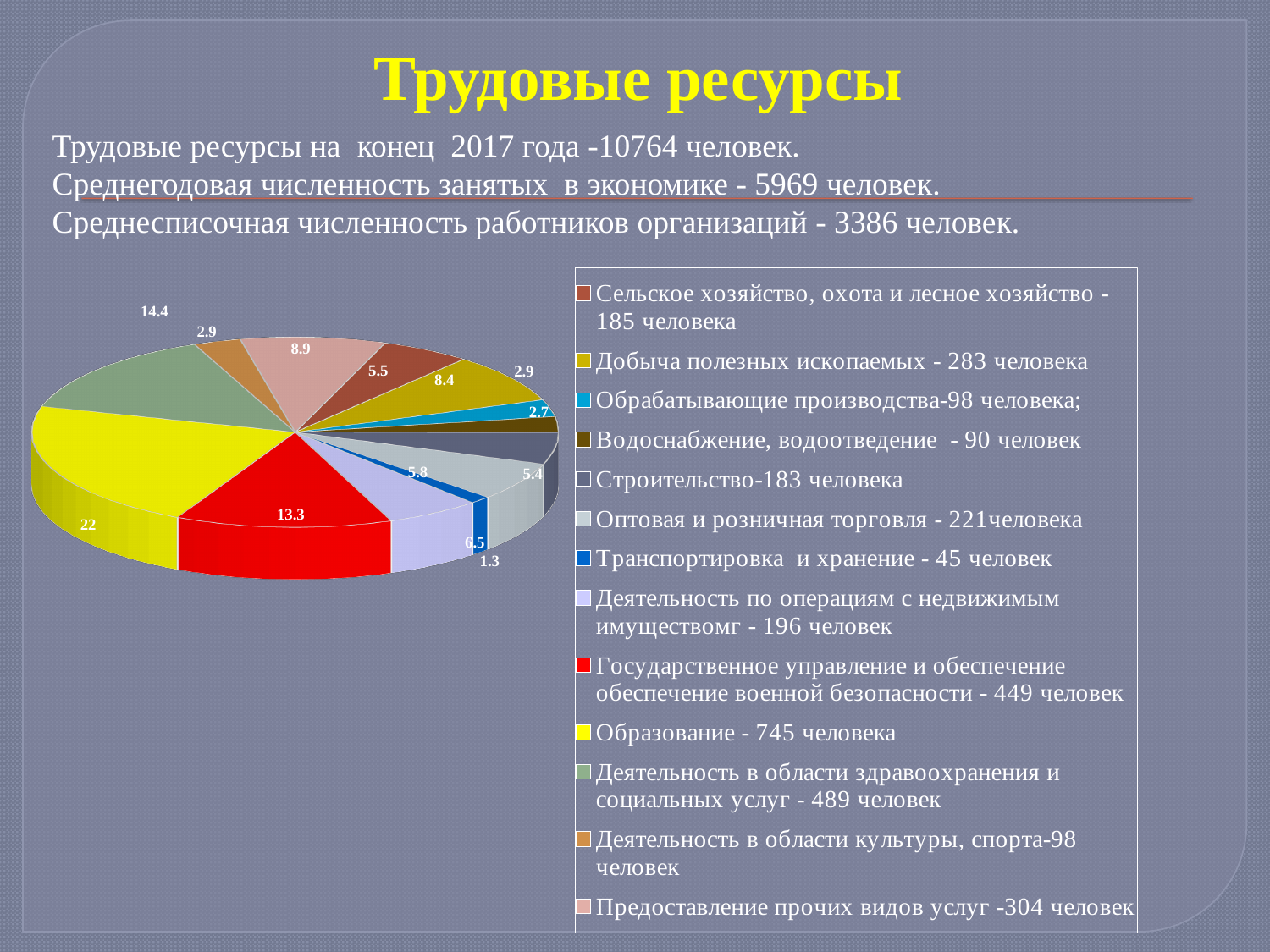
According to the legend, how many people are employed in Образование? 745 человека Which category has the largest slice of the pie chart? Образование What colour is the slice for Образование? yellow What is the data label on the slice for Предоставление прочих видов услуг? 8.9 How many categories does the legend of the pie chart list? 13 What is the data label on the slice for Государственное управление и обеспечение военной безопасности? 13.3 Which category has the smallest slice of the pie chart? Транспортировка и хранение Which slice is larger: Добыча полезных ископаемых or Сельское хозяйство, охота и лесное хозяйство? Добыча полезных ископаемых What is the difference between the data labels for Образование and Государственное управление и обеспечение военной безопасности? 8.7 What type of chart is shown on the slide? pie chart What is the data label on the slice for Деятельность в области здравоохранения и социальных услуг? 14.4 What is the data label on the slice for Образование? 22